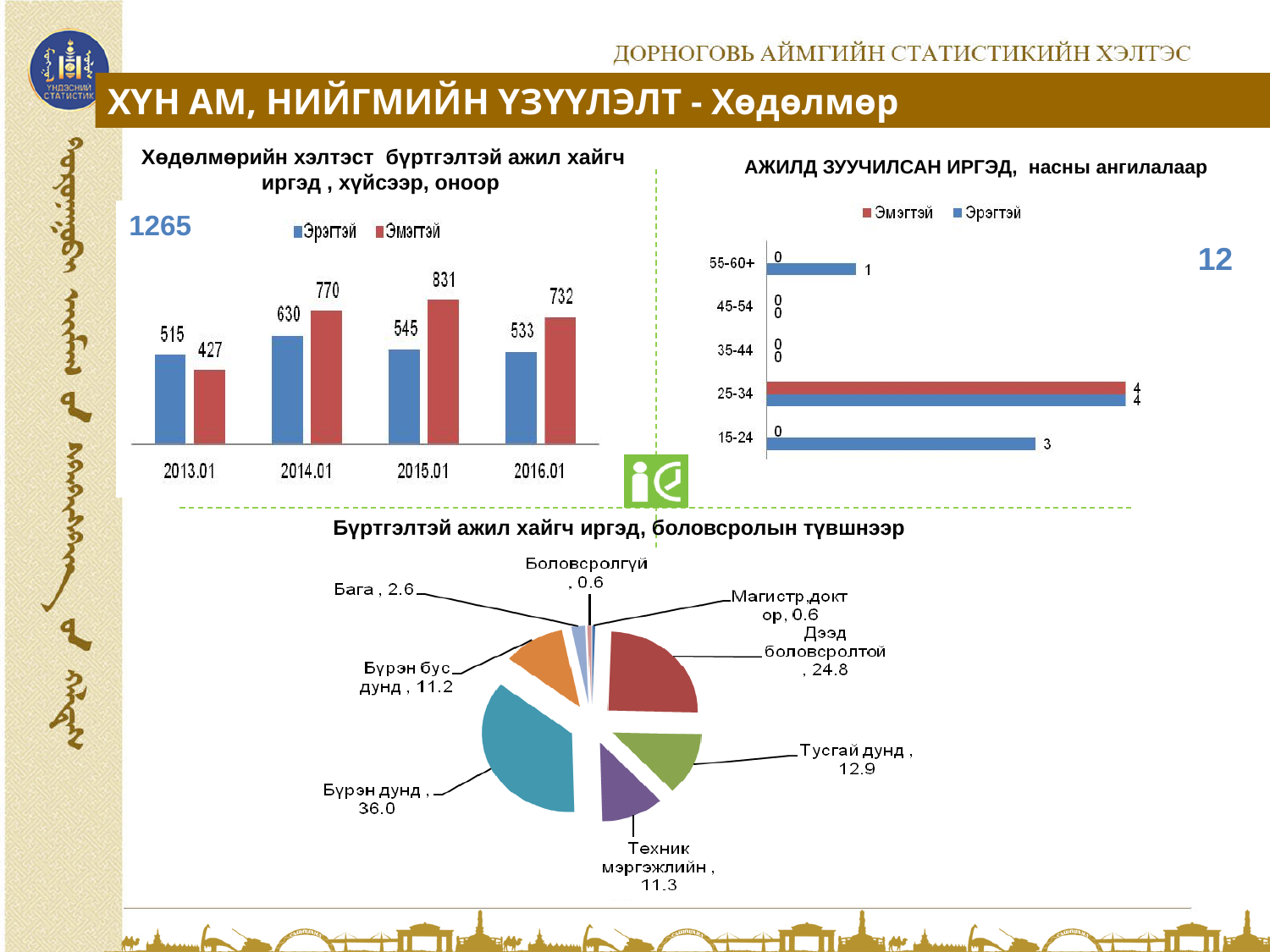
In the top-left chart 'Хөдөлмөрийн хэлтэст бүртгэлтэй ажил хайгч иргэд, хүйсээр, оноор', in which year is the Эмэгтэй value highest? 2015.01 How many series does the legend of the top-left chart 'Хөдөлмөрийн хэлтэст бүртгэлтэй ажил хайгч иргэд, хүйсээр, оноор' list? 2 In the top-left chart 'Хөдөлмөрийн хэлтэст бүртгэлтэй ажил хайгч иргэд, хүйсээр, оноор', which is larger in 2013.01, Эрэгтэй or Эмэгтэй? Эрэгтэй In the top-left chart 'Хөдөлмөрийн хэлтэст бүртгэлтэй ажил хайгч иргэд, хүйсээр, оноор', what is the value for Эмэгтэй in 2015.01? 831 What kind of chart is the bottom chart 'Бүртгэлтэй ажил хайгч иргэд, боловсролын түвшнээр'? pie chart How many age categories are shown in the top-right chart 'АЖИЛД ЗУУЧИЛСАН ИРГЭД, насны ангилалаар'? 5 In the top-left chart 'Хөдөлмөрийн хэлтэст бүртгэлтэй ажил хайгч иргэд, хүйсээр, оноор', what is the difference between the Эмэгтэй and Эрэгтэй values in 2014.01? 140 In the top-right chart 'АЖИЛД ЗУУЧИЛСАН ИРГЭД, насны ангилалаар', what is the Эмэгтэй value for the 25-34 age group? 4 In the bottom pie chart 'Бүртгэлтэй ажил хайгч иргэд, боловсролын түвшнээр', which slice is the largest? Бүрэн дунд In the top-right chart 'АЖИЛД ЗУУЧИЛСАН ИРГЭД, насны ангилалаар', what is the Эрэгтэй value for the 15-24 age group? 3 In the bottom pie chart 'Бүртгэлтэй ажил хайгч иргэд, боловсролын түвшнээр', what is the value for Дээд боловсролтой? 24.8 In the top-left chart 'Хөдөлмөрийн хэлтэст бүртгэлтэй ажил хайгч иргэд, хүйсээр, оноор', what is the value for Эрэгтэй in 2013.01? 515